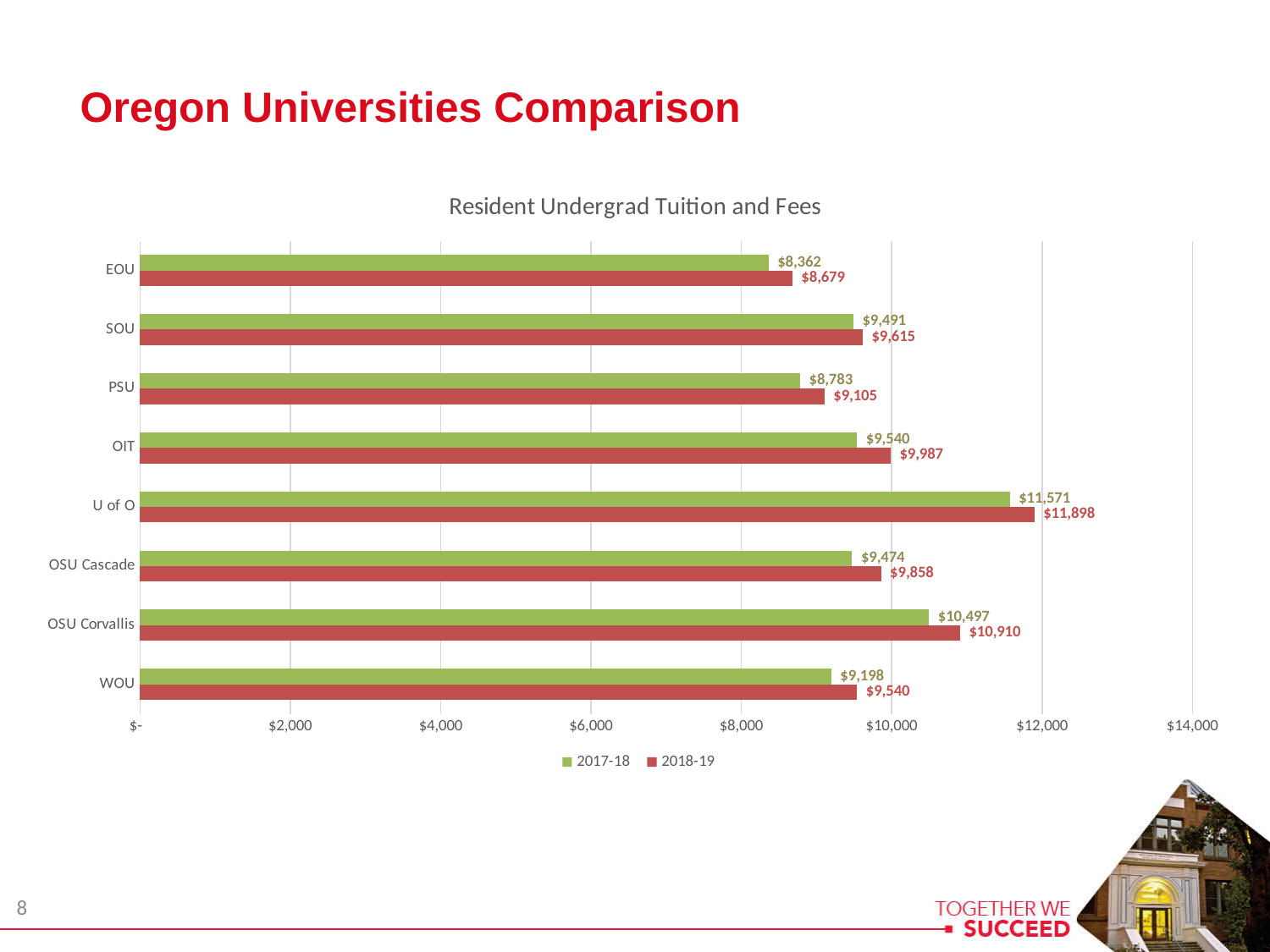
What kind of chart is shown on the slide? bar chart What is the 2018-19 value for OSU Cascade? $9,858 Which is larger, the 2018-19 value for OIT or the 2018-19 value for SOU? OIT Which university has the lowest 2017-18 tuition and fees? EOU What is the 2018-19 resident undergrad tuition and fees value for U of O? $11,898 How many series does the legend list? 2 What is the title of the chart? Resident Undergrad Tuition and Fees What is the difference between the 2018-19 and 2017-18 values for OSU Corvallis? $413 How many universities are shown on the chart? 8 Is the 2018-19 value for WOU greater or less than $10,000? less Which university has the highest 2018-19 tuition and fees? U of O What is the 2017-18 value for PSU? $8,783